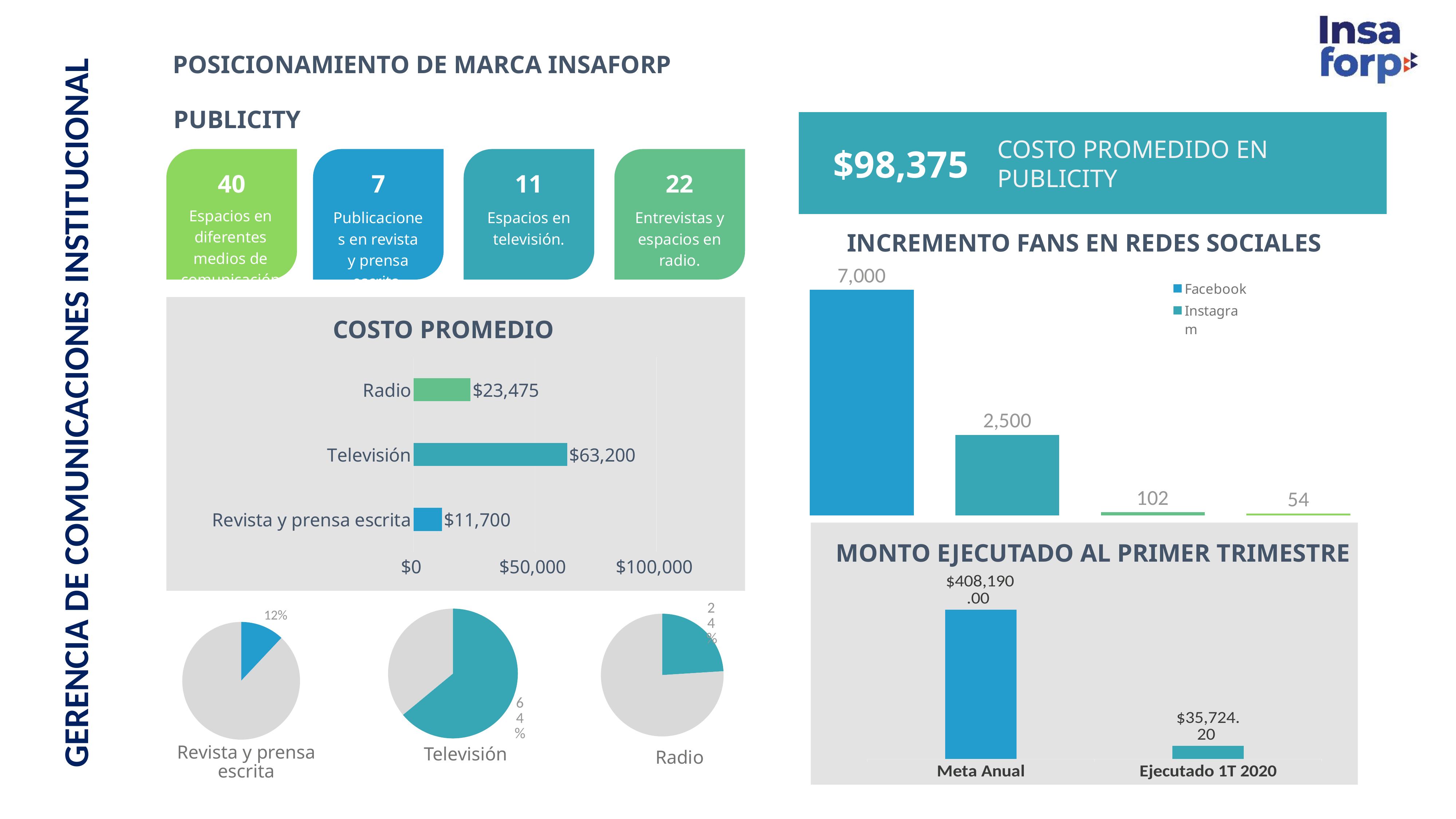
What kind of chart is the COSTO PROMEDIO chart? Bar chart In the COSTO PROMEDIO chart, which category has the highest value? Televisión In the COSTO PROMEDIO chart, what is the difference between Televisión and Radio? $39,725 In the COSTO PROMEDIO chart, what is the value for Televisión? $63,200 In the pie chart labelled Televisión, what share does the coloured slice represent? 64% In the COSTO PROMEDIO chart, which category has the lowest value? Revista y prensa escrita In the COSTO PROMEDIO chart, what is the value for Radio? $23,475 In the COSTO PROMEDIO chart, what is the value for Revista y prensa escrita? $11,700 In the MONTO EJECUTADO AL PRIMER TRIMESTRE chart, what is the value for Ejecutado 1T 2020? $35,724.20 In the INCREMENTO FANS EN REDES SOCIALES chart, what is the value of the tallest bar? 7,000 In the COSTO PROMEDIO chart, how many categories are shown? 3 In the INCREMENTO FANS EN REDES SOCIALES chart, how many series does the legend list? 2